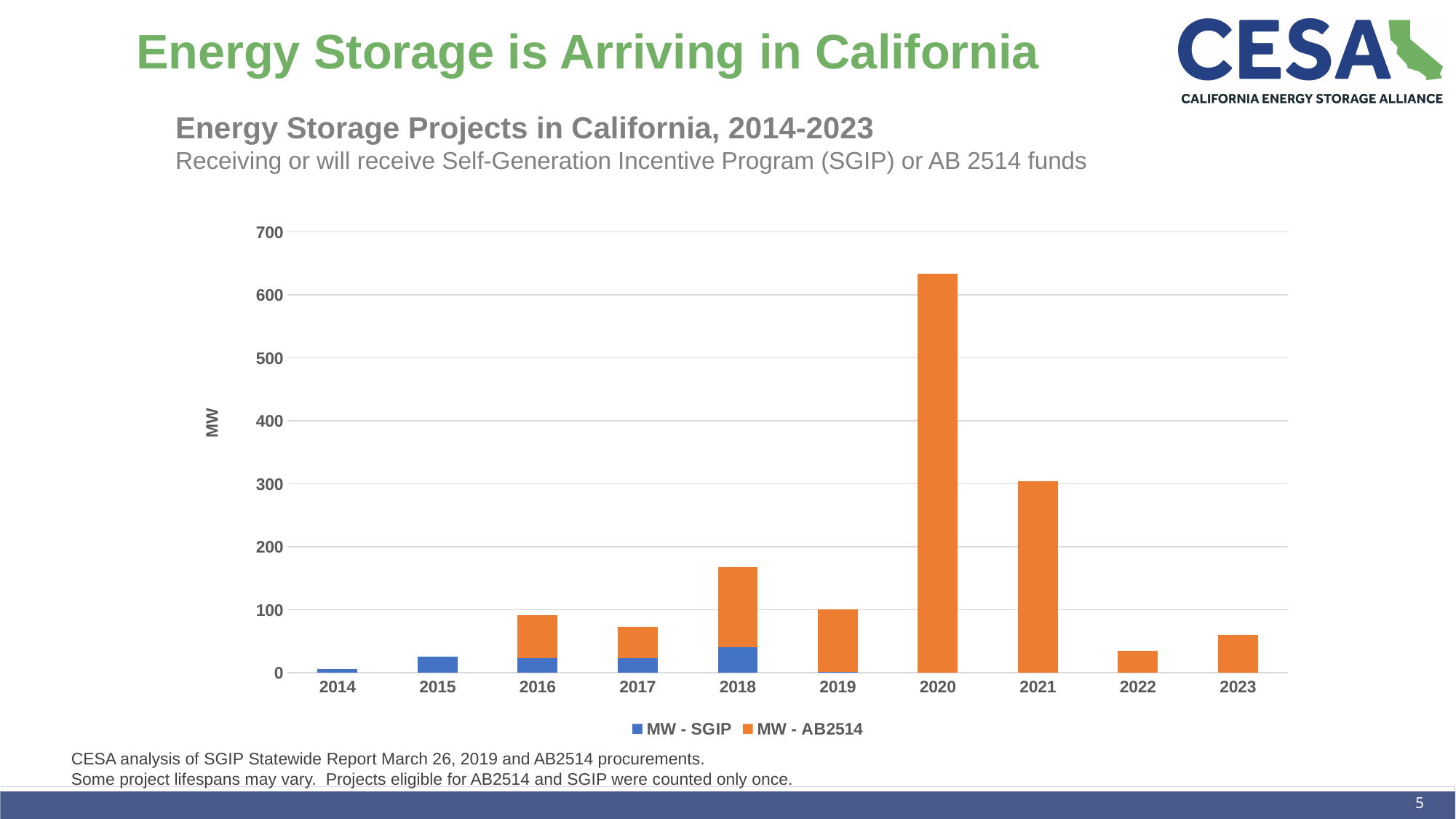
How many years are shown on the x axis? 10 Which year has the lowest total MW? 2014 Which year has the highest total MW? 2020 Is the total value for 2022 greater or less than 100? less Is the total value for 2020 greater or less than 600? greater What kind of chart is shown on the slide? bar chart Which year has a larger total MW, 2020 or 2021? 2020 How many series does the legend list? 2 Which year has a larger total MW, 2017 or 2018? 2018 What is the label on the y axis? MW Is the total value for 2018 greater or less than 200? less